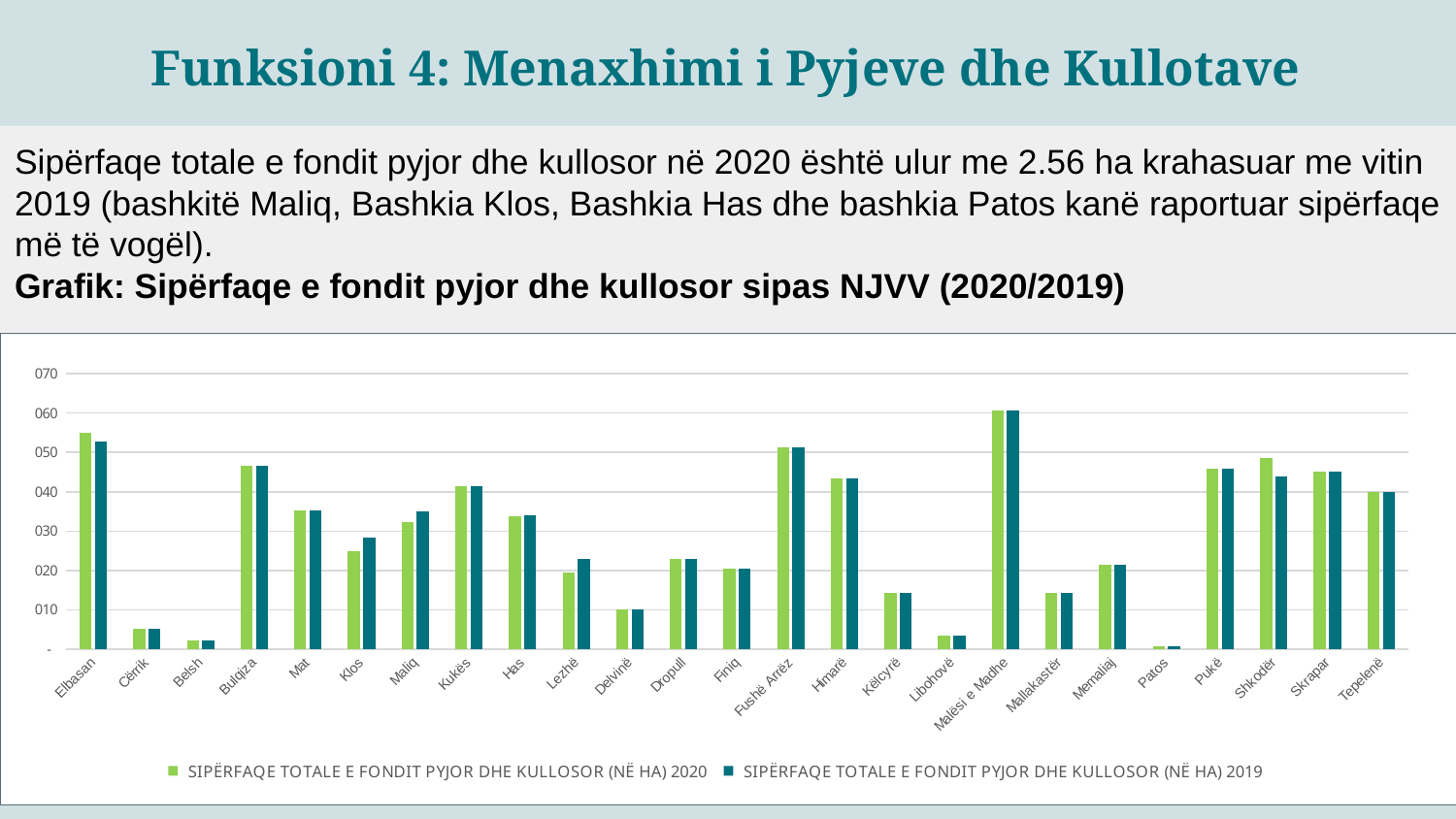
Which municipality has the highest value for the 2020 series? Malësi e Madhe Is the 2019 value for Delvinë greater or less than 020? less Is the 2020 value for Elbasan greater or less than 050? greater How many municipalities (categories) are shown on the x axis? 25 Which municipality has the lowest value for the 2020 series? Patos For Shkodër, which series has the larger value, 2020 or 2019? 2020 How many series does the legend list? 2 Which colour represents the 2019 series in the chart? dark teal What kind of chart is shown on the slide? bar chart For Klos, which series has the larger value, 2020 or 2019? 2019 Is the 2020 value for Fushë Arrëz greater or less than 050? greater